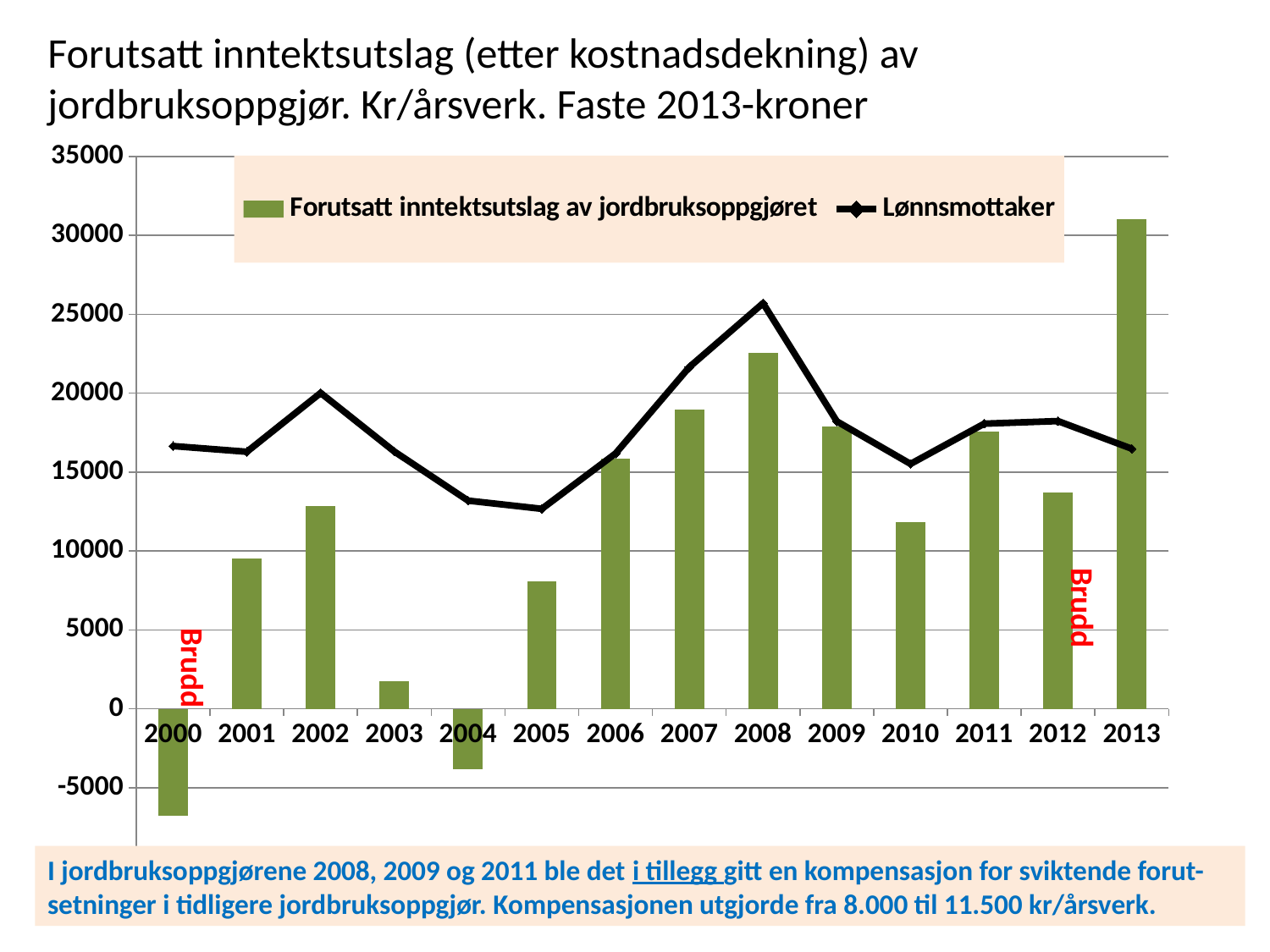
Which year has the highest bar for Forutsatt inntektsutslag av jordbruksoppgjøret? 2013 In which year does the Lønnsmottaker line reach its lowest point? 2005 Which year has a higher bar, 2007 or 2010? 2007 Is the bar value for 2003 greater or less than 5000? less In which year does the Lønnsmottaker line reach its highest point? 2008 Is the Lønnsmottaker value for 2004 greater or less than 15000? less How many series does the legend list? 2 What kind of chart is shown on the slide? A combined bar and line chart Is the bar value for 2013 greater or less than 30000? greater How many years are shown on the x axis? 14 Which year has the lowest bar for Forutsatt inntektsutslag av jordbruksoppgjøret? 2000